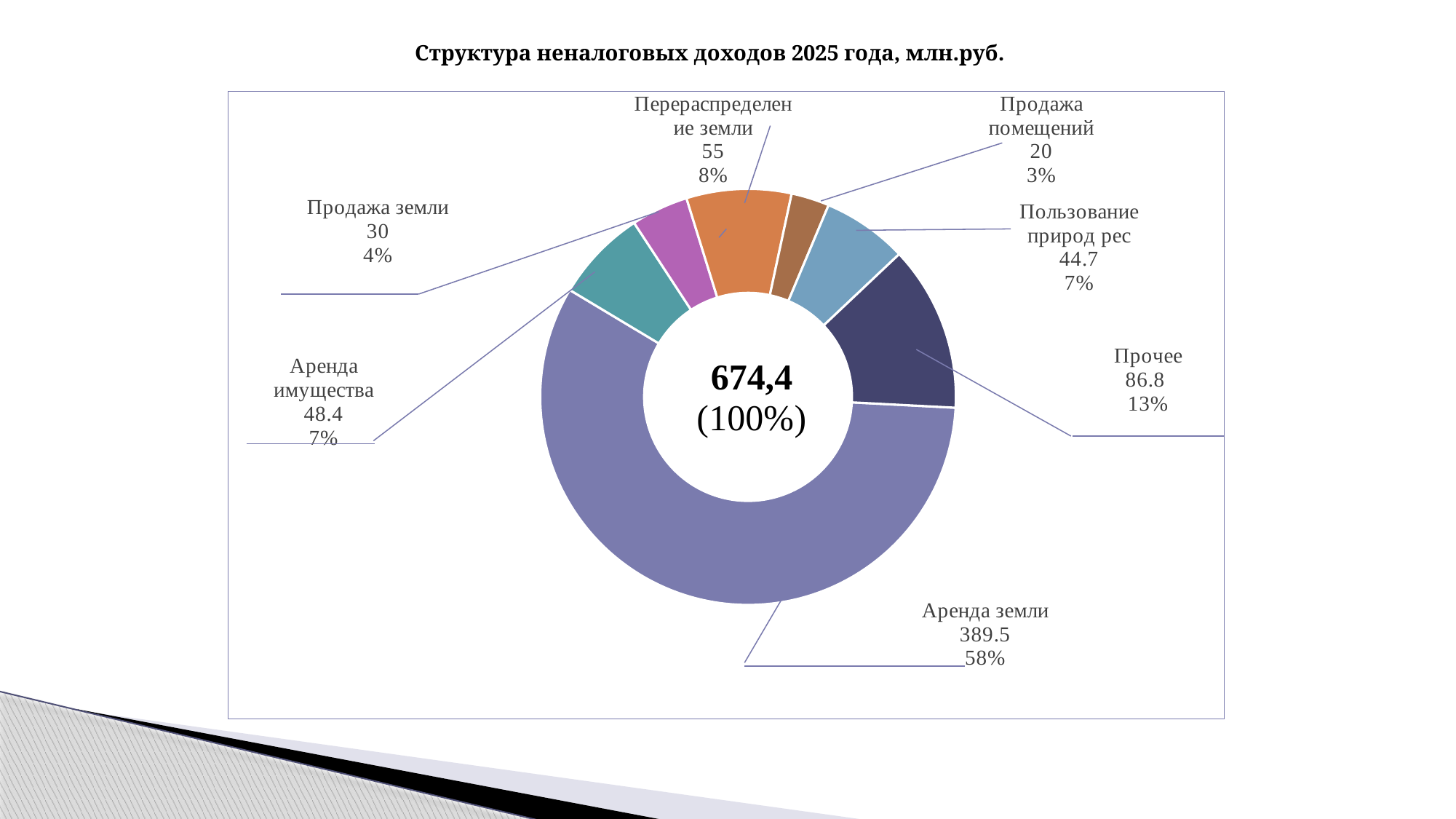
How many categories does the chart show? 7 What share of the total does Перераспределение земли represent? 8% What is the value for Продажа помещений? 20 Which category has the highest value? Аренда земли What is the value for Прочее? 86.8 Which category has the lowest value? Продажа помещений What is the value for Аренда земли? 389.5 What share of the total does Аренда земли represent? 58% Which is larger, Аренда имущества or Пользование природ рес? Аренда имущества What is the value for Пользование природ рес? 44.7 What is the difference between Прочее and Перераспределение земли? 31.8 What type of chart is shown on the slide? Doughnut (pie) chart